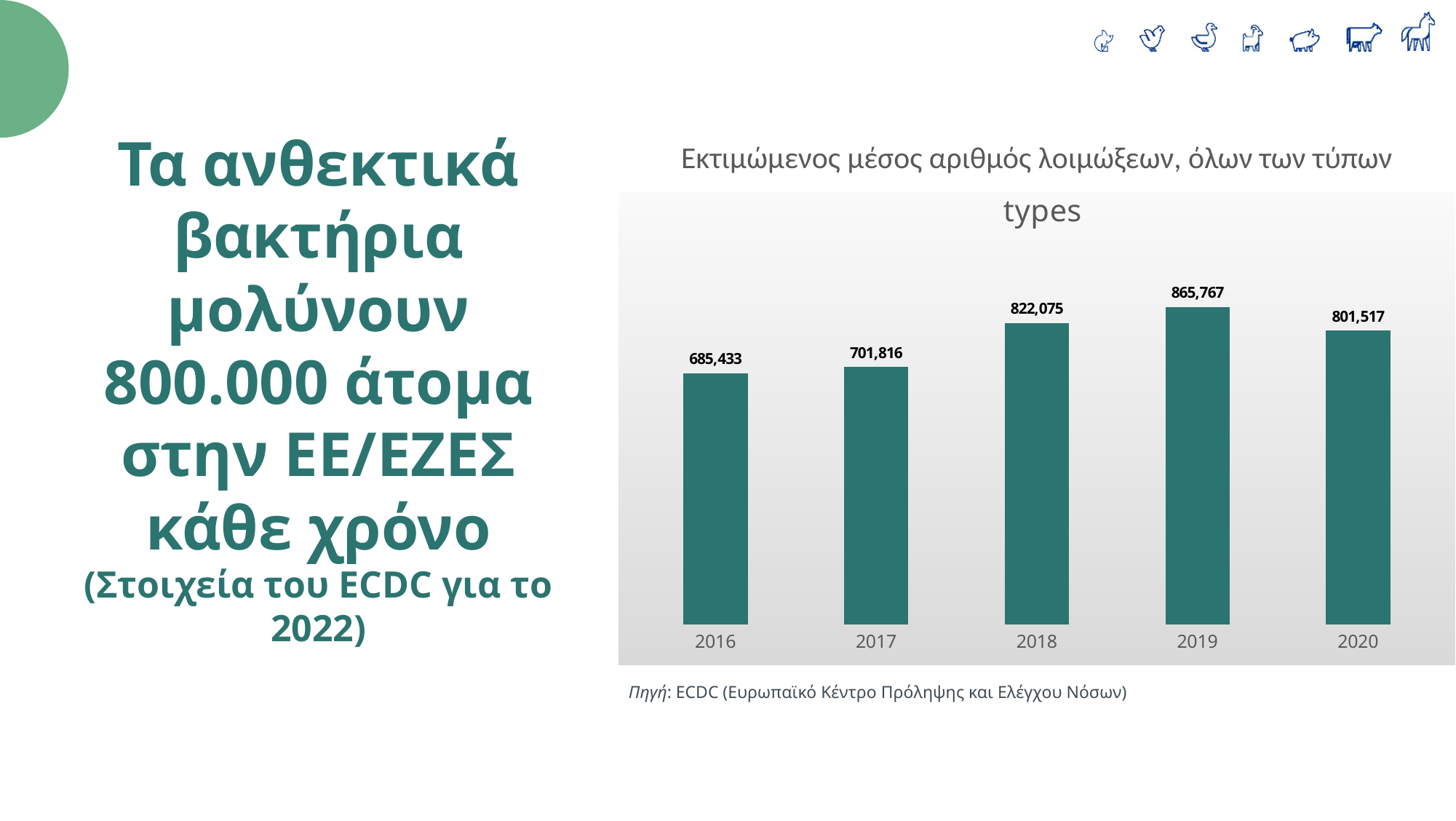
What is the source cited below the chart? ECDC (Ευρωπαϊκό Κέντρο Πρόληψης και Ελέγχου Νόσων) What is the estimated number of infections shown for 2016? 685,433 Which is larger, the value for 2019 or the value for 2020? 2019 What is the value shown for 2020? 801,517 What kind of chart is shown on the slide? Bar chart Which year has the highest value? 2019 Which year has the lowest value? 2016 What is the difference between the values for 2019 and 2018? 43,692 By how much does the value for 2020 exceed the value for 2016? 116,084 How many years are shown on the x axis? 5 What is the value shown for 2018? 822,075 Do the values rise or fall from 2016 to 2019? Rise